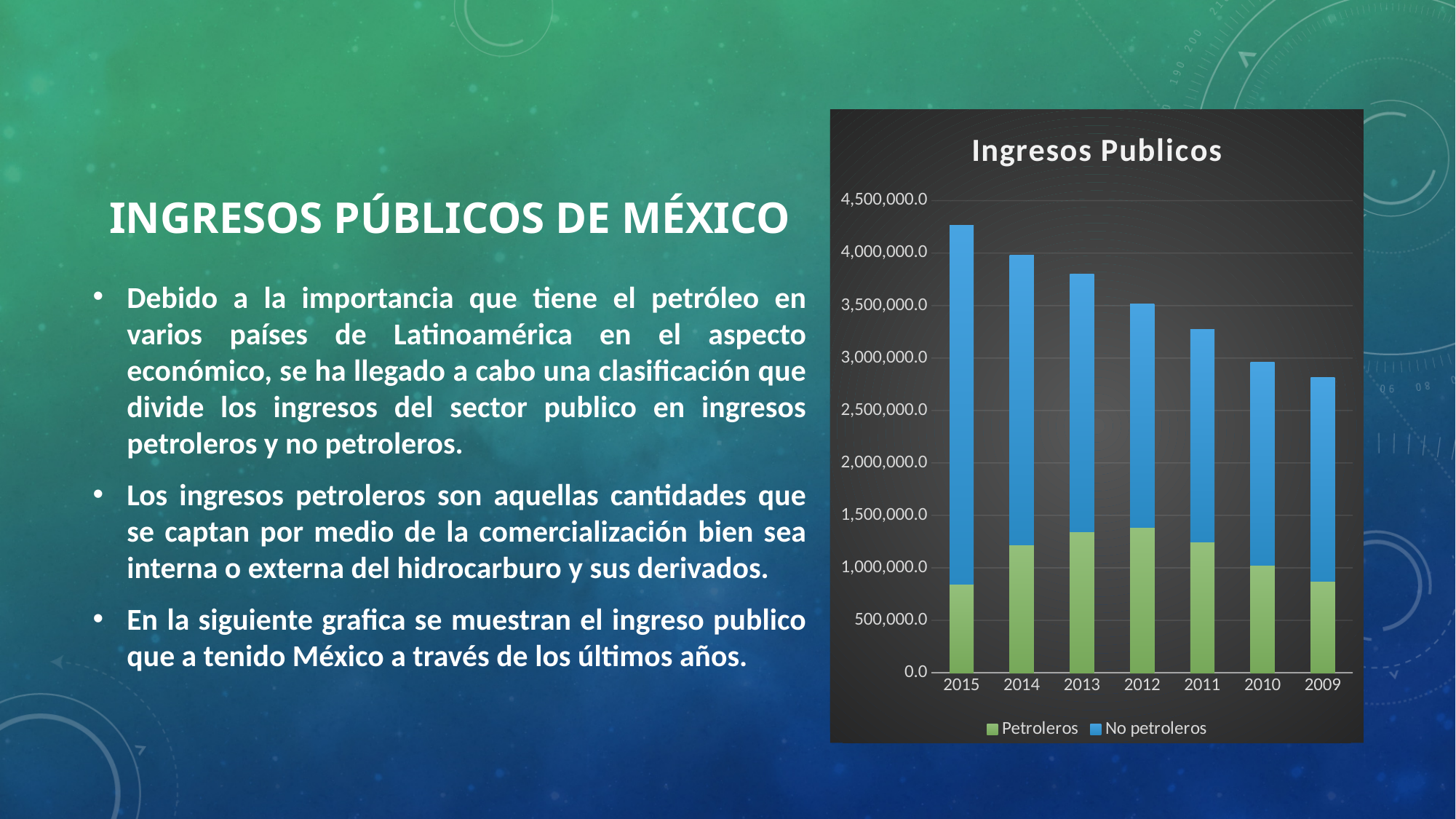
Is the total stacked bar for 2015 greater or less than 4,000,000.0? greater Which is larger, the total stacked bar for 2013 or for 2011? 2013 How many series does the legend list? 2 Do the total bar heights rise or fall moving from left (2015) to right (2009) along the x axis? fall Which colour represents the No petroleros series? blue Is the total stacked bar for 2009 greater or less than 3,000,000.0? less What kind of chart is shown on the slide? stacked bar chart Which year has the highest total stacked bar? 2015 Is the Petroleros value for 2015 greater or less than 1,000,000.0? less How many years are shown on the x axis of the chart? 7 Which year has the lowest total stacked bar? 2009 What is the title of the chart? Ingresos Publicos